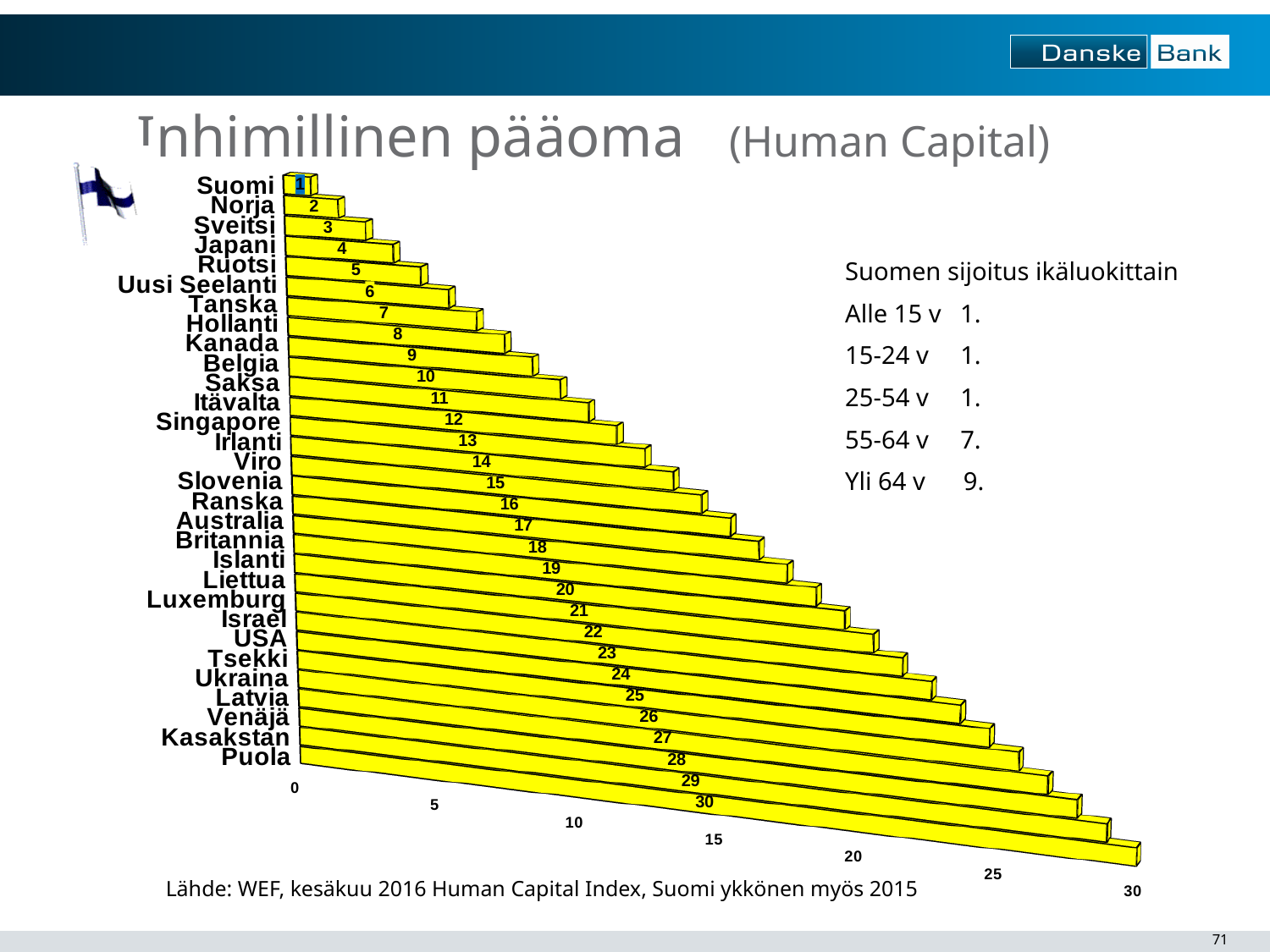
What value is shown for Kanada? 9 Which category has the shortest bar? Suomi What is the title of the slide containing the chart? Inhimillinen pääoma (Human Capital) What is the difference between the values for Puola and Suomi? 29 Is the value for Islanti greater or less than 15? greater What value is shown for USA? 24 How many countries are shown in the chart? 30 What kind of chart is shown on the slide? bar chart Which category has the longest bar? Puola What value is shown for Puola? 30 Which has the larger value, Ranska or Belgia? Ranska What value is shown for Suomi? 1